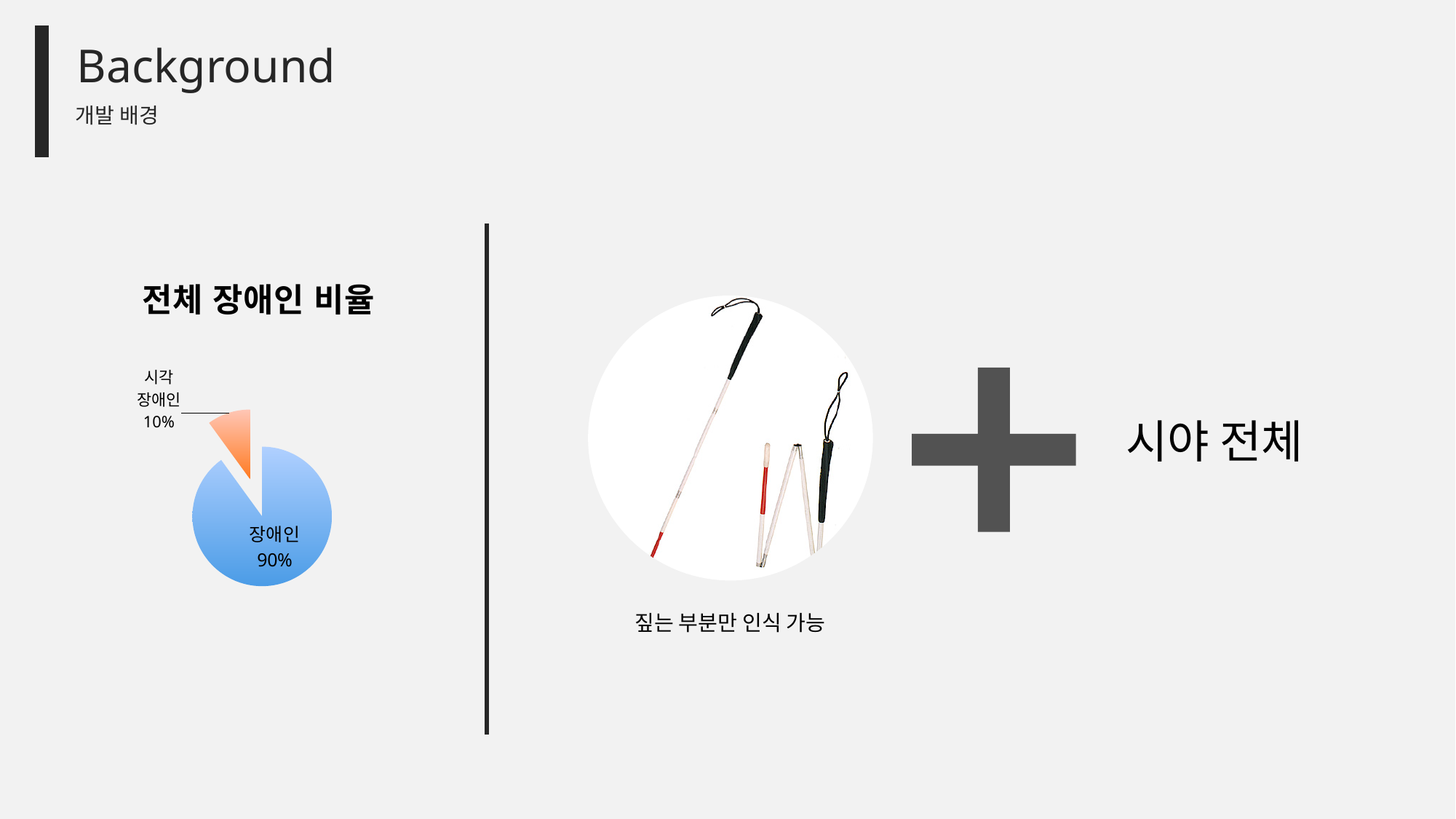
What kind of chart is shown under the title 전체 장애인 비율? pie chart Which slice of the pie chart is the smallest? 시각 장애인 What share of the pie does 시각 장애인 represent? 10% Which slice is larger, 장애인 or 시각 장애인? 장애인 What is the difference in percentage points between the 장애인 slice and the 시각 장애인 slice? 80 percentage points What share of the pie does 장애인 represent? 90% Which slice of the pie chart is the largest? 장애인 Is the share for 시각 장애인 greater or less than 50%? less What colour is the 시각 장애인 slice of the pie chart? orange What is the title of the pie chart on the slide? 전체 장애인 비율 How many slices does the pie chart have? 2